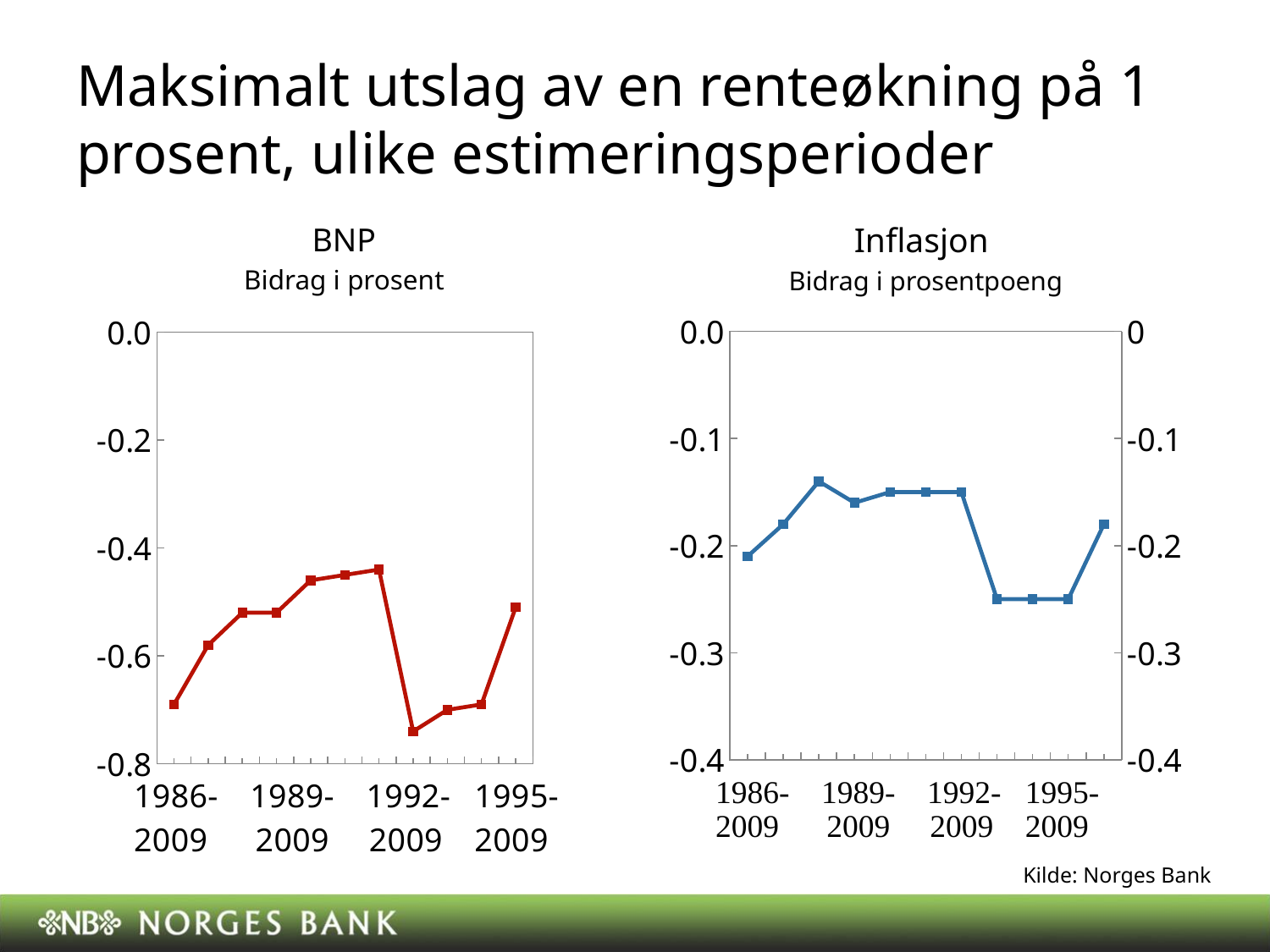
In the BNP chart, do the values rise or fall from 1986-2009 to 1989-2009? rise In the Inflasjon chart, which is larger, the value for 1989-2009 or the value for 1995-2009? 1989-2009 In the BNP chart, is the value for 1989-2009 greater or less than -0.6? greater In the Inflasjon chart, is the value for 1995-2009 greater or less than -0.2? less In the BNP chart, is the value for 1986-2009 greater or less than -0.6? less What kind of chart is the BNP chart on the left? Line chart What is the subtitle shown under the Inflasjon chart title? Bidrag i prosentpoeng In the Inflasjon chart, how many data points are plotted? 11 In the BNP chart, how many data points are plotted? 11